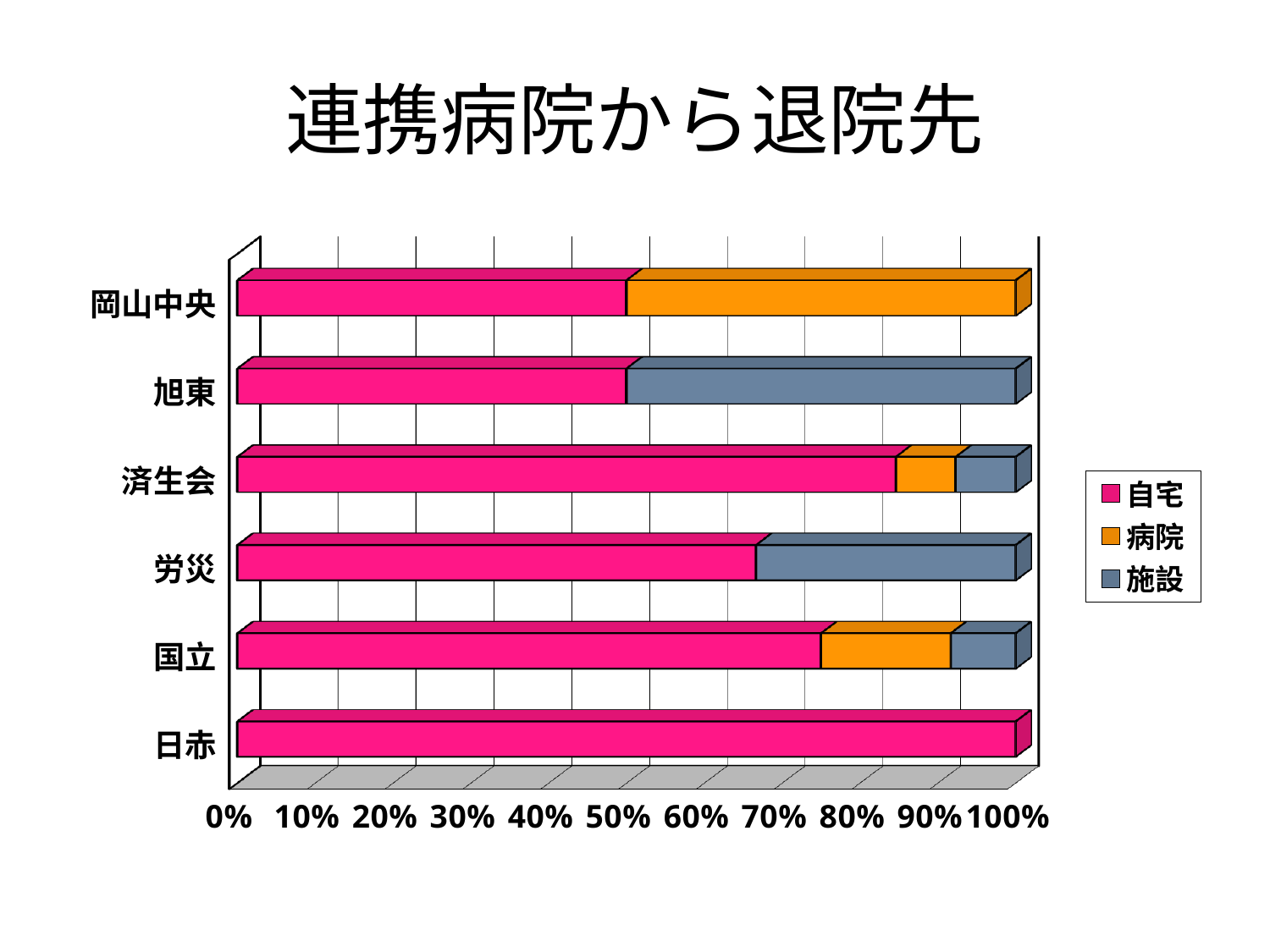
Is the 自宅 share for 日赤 greater or less than 90%? greater What are the three legend entries of the chart? 自宅, 病院, 施設 Which hospital has the largest share of 病院? 岡山中央 Which has the larger 施設 share, 労災 or 国立? 労災 How many series does the legend list? 3 Is the 自宅 share for 労災 greater or less than 60%? greater Is the 自宅 share for 済生会 greater or less than 80%? greater Which hospital has the highest share of 自宅? 日赤 What kind of chart is shown on the slide? Stacked bar chart What is the title of the chart? 連携病院から退院先 How many hospitals (categories) are shown on the chart? 6